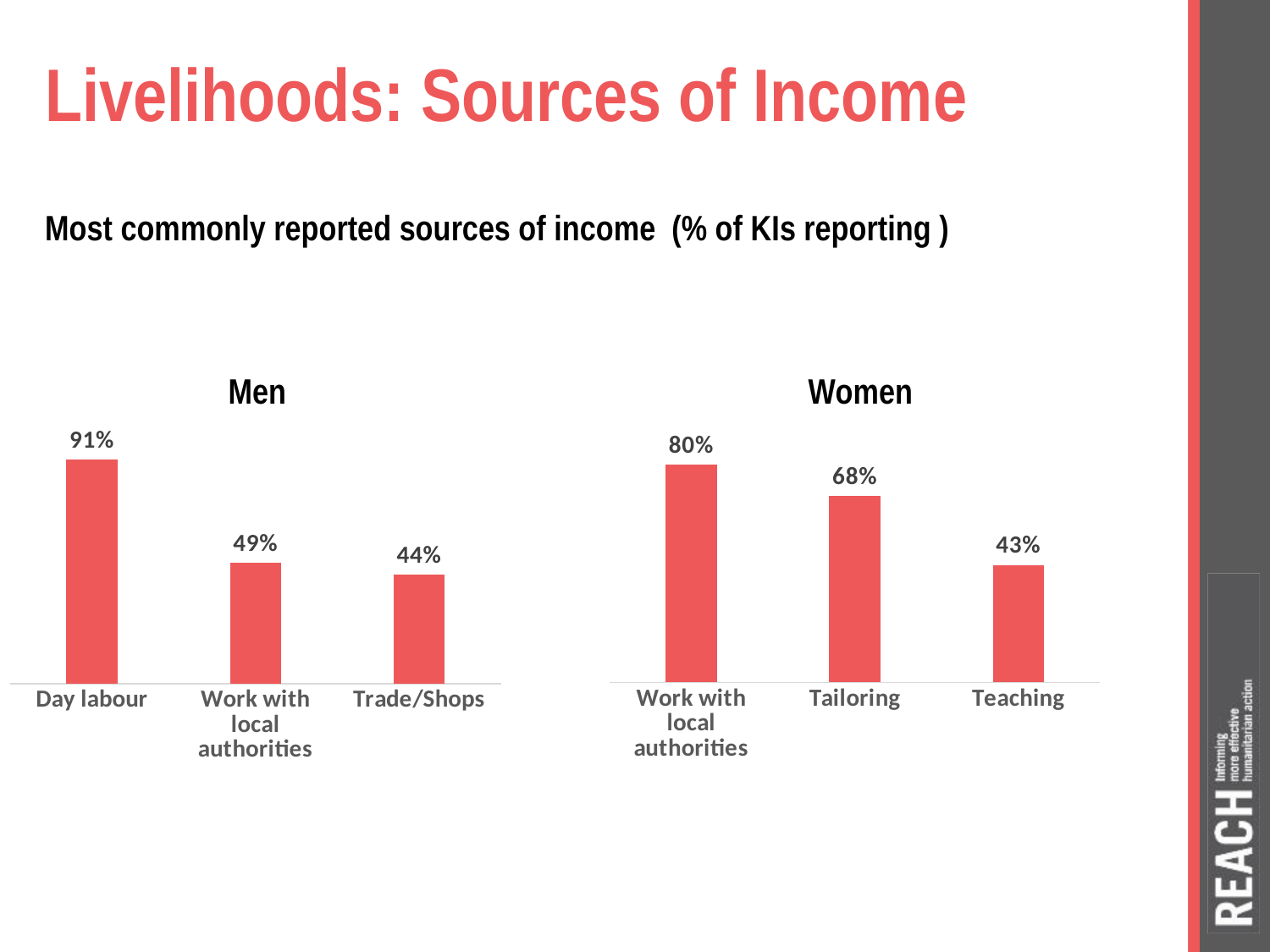
What is the title of the chart on the right side of the slide? Women In the Men chart, which source of income has the lowest value? Trade/Shops In the Men chart, what percentage of KIs reported Day labour as a source of income? 91% In the Men chart, what is the value for Trade/Shops? 44% In the Men chart, what is the difference between Day labour and Work with local authorities? 42% What type of chart is the Men chart? Bar chart In the Women chart, what percentage of KIs reported Tailoring? 68% In the Women chart, do the values rise or fall from left to right? Fall Which is larger: the value for Work with local authorities in the Men chart or in the Women chart? Women How many categories are shown in the Women chart? 3 In the Women chart, which source of income has the highest value? Work with local authorities In the Women chart, what is the difference between the values for Work with local authorities and Teaching? 37%